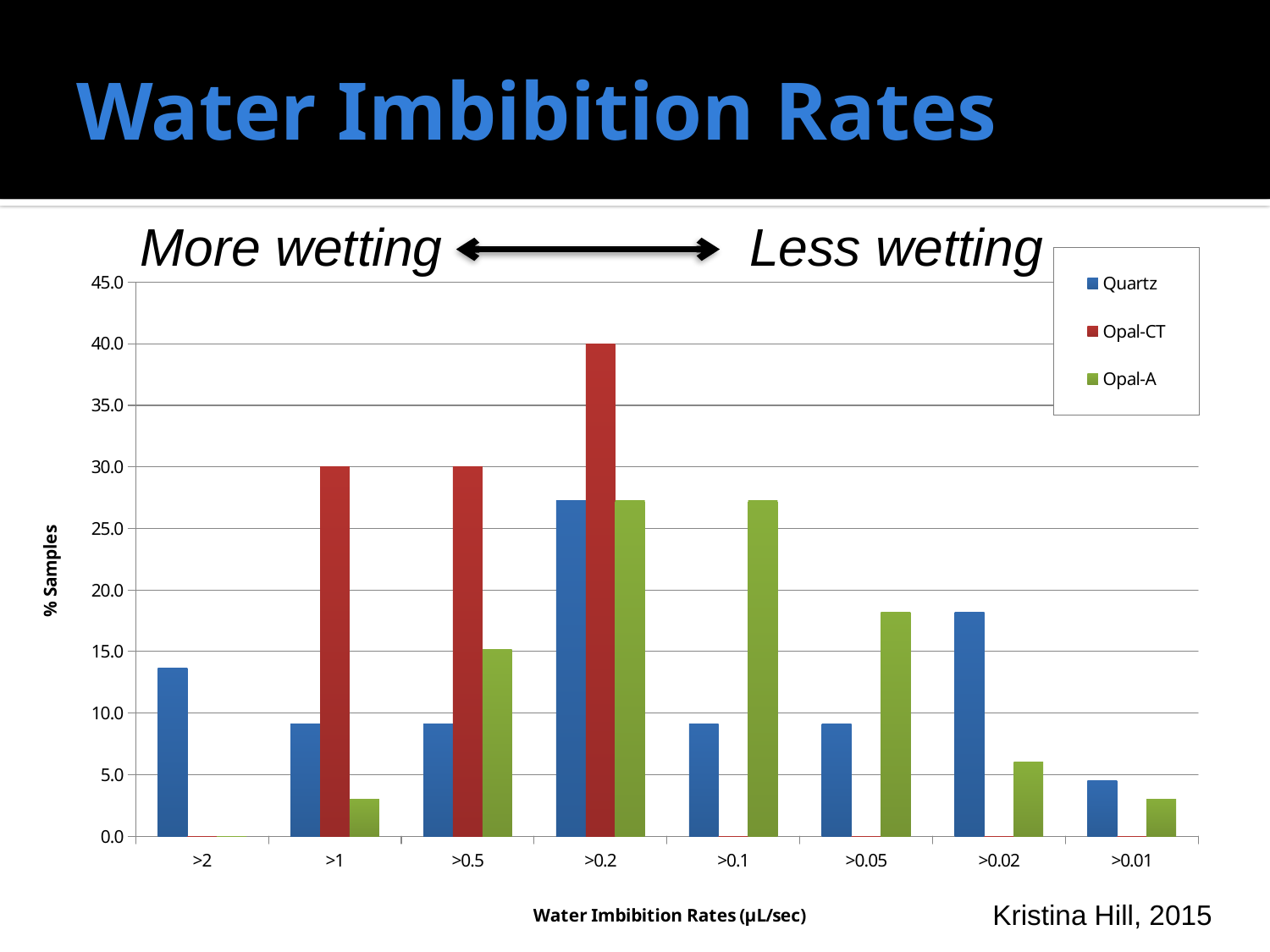
What is the value for Opal-CT in the >0.2 category? 40.0 In the >0.2 category, which is larger, Opal-CT or Quartz? Opal-CT Is the value for Quartz in the >2 category greater or less than 10.0? greater In which category is the Quartz value highest? >0.2 What is the value for Opal-CT in the >1 category? 30.0 In which category is the Quartz value lowest? >0.01 What type of chart is shown on the slide? bar chart In the >0.05 category, which is larger, Opal-A or Quartz? Opal-A What is the title of the vertical axis? % Samples How many series does the legend list? 3 In which category is the Opal-CT value highest? >0.2 How many categories are shown on the x axis? 8